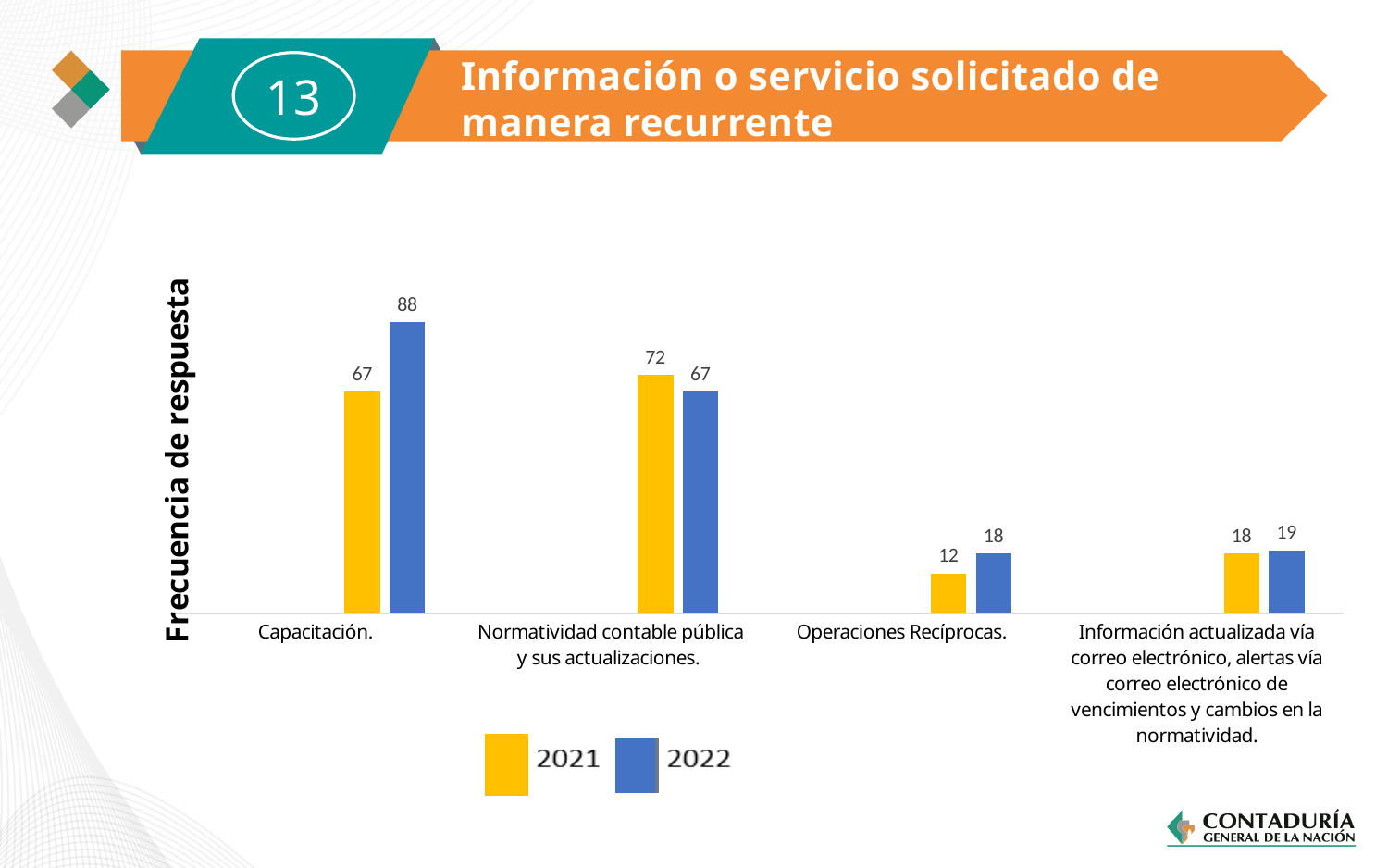
For Normatividad contable pública y sus actualizaciones, which year has the larger value, 2021 or 2022? 2021 Which category has the highest 2022 value? Capacitación. Which colour represents the 2021 series in the legend? Yellow How many categories are shown on the x axis? 4 What is the 2022 value for Capacitación? 88 How many series does the legend list? 2 What is the 2021 value for Operaciones Recíprocas? 12 What kind of chart is shown on the slide? Bar chart What is the label of the vertical axis? Frecuencia de respuesta What is the difference between the 2022 and 2021 values for Capacitación? 21 Which category has the lowest 2021 value? Operaciones Recíprocas. What is the 2021 value for Normatividad contable pública y sus actualizaciones? 72